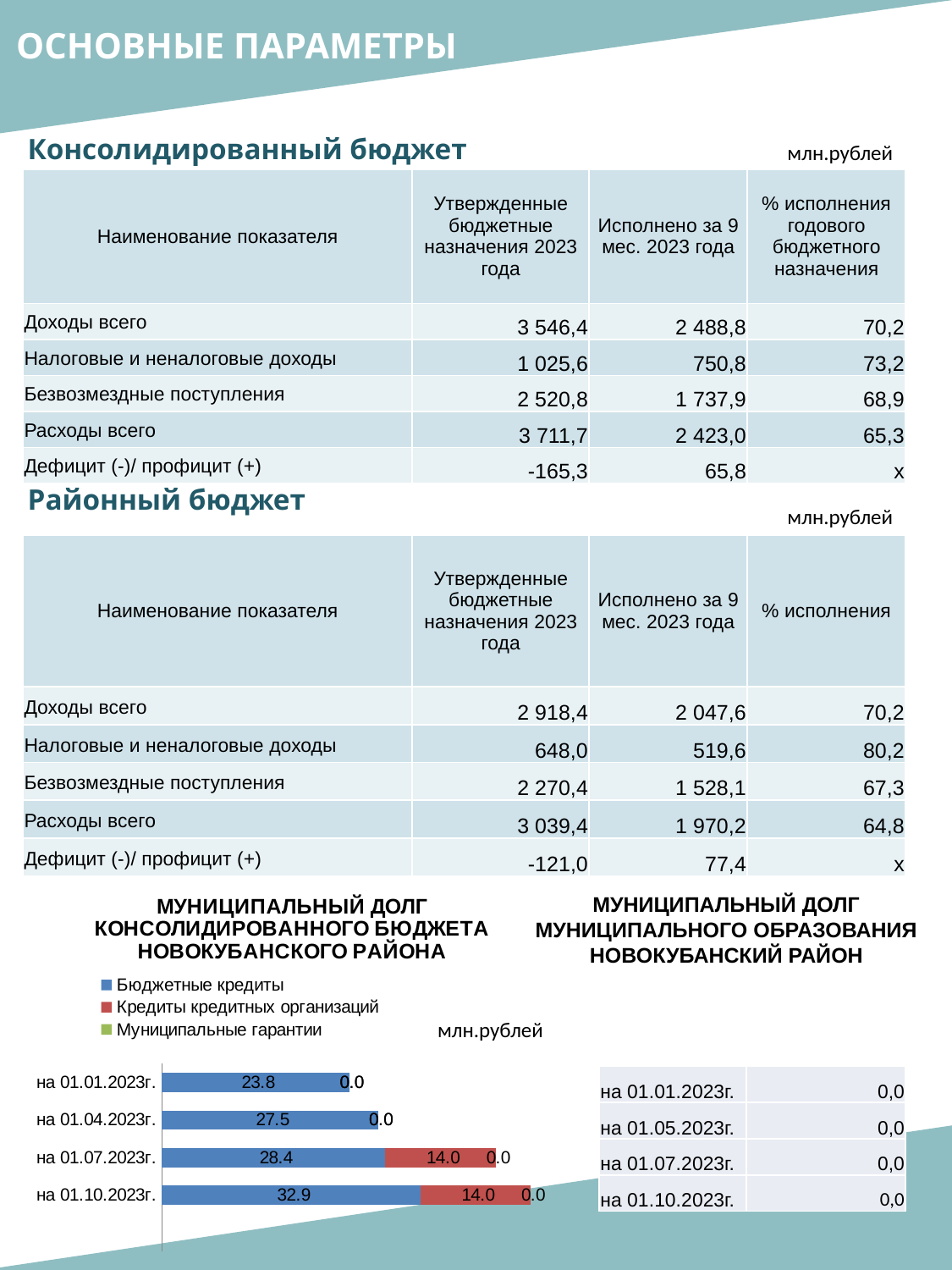
In the municipal debt chart, what is the value of 'Бюджетные кредиты' on 01.01.2023? 23.8 In the municipal debt chart, do the 'Бюджетные кредиты' values rise or fall from 01.01.2023 to 01.10.2023? rise What kind of chart is shown under the title 'МУНИЦИПАЛЬНЫЙ ДОЛГ КОНСОЛИДИРОВАННОГО БЮДЖЕТА НОВОКУБАНСКОГО РАЙОНА'? bar chart In the municipal debt chart, what is the total debt on 01.10.2023 (sum of all series)? 46.9 In the municipal debt chart, what is the value of 'Бюджетные кредиты' on 01.10.2023? 32.9 In the municipal debt chart, what is the value of 'Кредиты кредитных организаций' on 01.07.2023? 14.0 In the municipal debt chart, on which date is 'Бюджетные кредиты' highest? на 01.10.2023г. How many series does the legend of the municipal debt chart list? 3 In the municipal debt chart, which colour represents 'Кредиты кредитных организаций'? red In the municipal debt chart, on which date is 'Бюджетные кредиты' lowest? на 01.01.2023г. In the municipal debt chart, what is the difference between 'Бюджетные кредиты' on 01.10.2023 and on 01.01.2023? 9.1 How many dates (categories) are shown on the municipal debt chart? 4